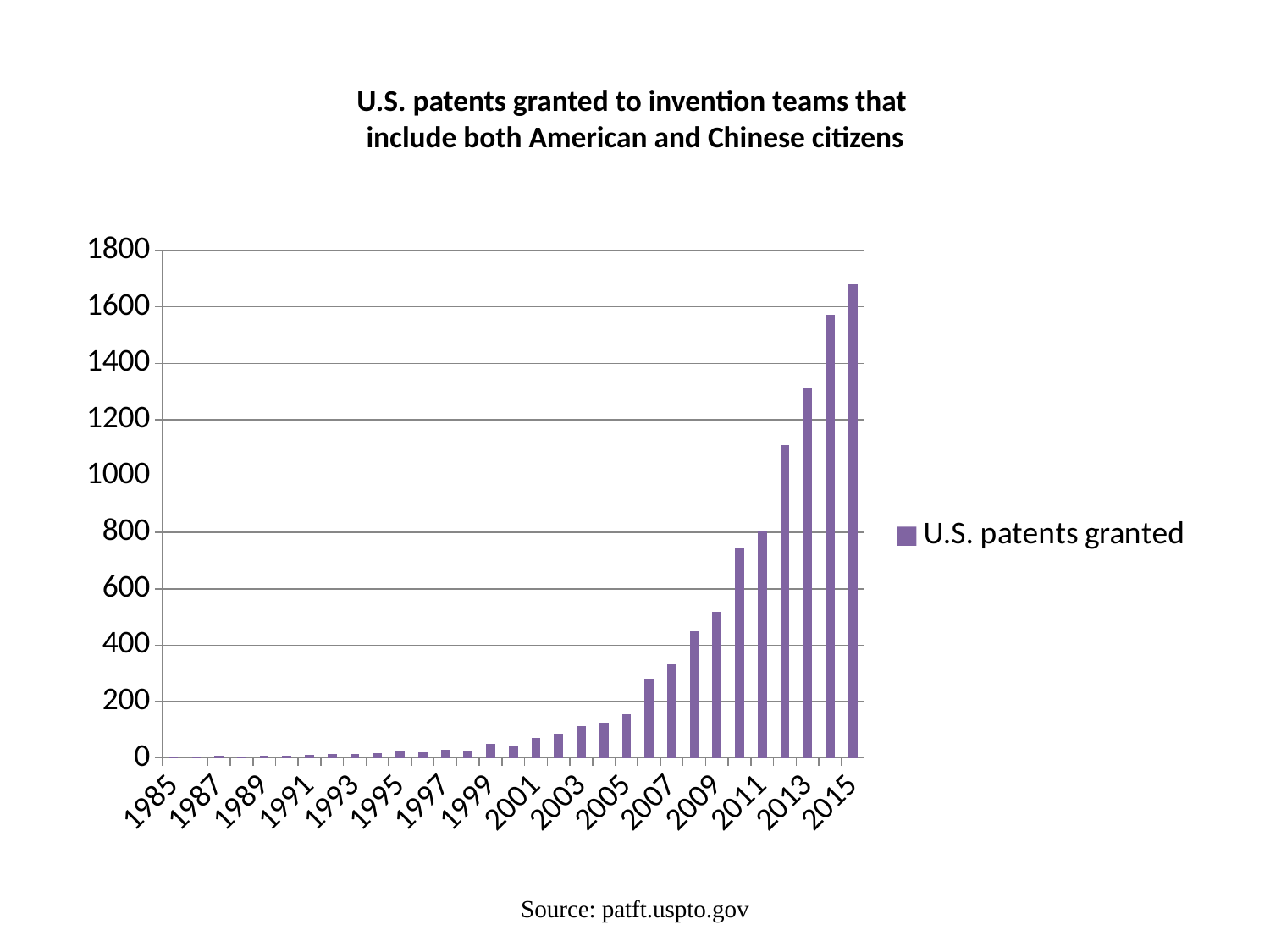
What kind of chart is shown on the slide? bar chart Is the value for 2015 greater or less than 1600? greater Is the value for 2012 greater or less than 1000? greater How many series does the legend list? 1 Which is larger, the value for 2011 or the value for 2009? 2011 Is the value for 2007 greater or less than 400? less Do the values generally rise or fall from 1985 to 2015? rise What source is cited below the chart? patft.uspto.gov Which year has the highest number of U.S. patents granted? 2015 What is the name of the series shown in the legend? U.S. patents granted